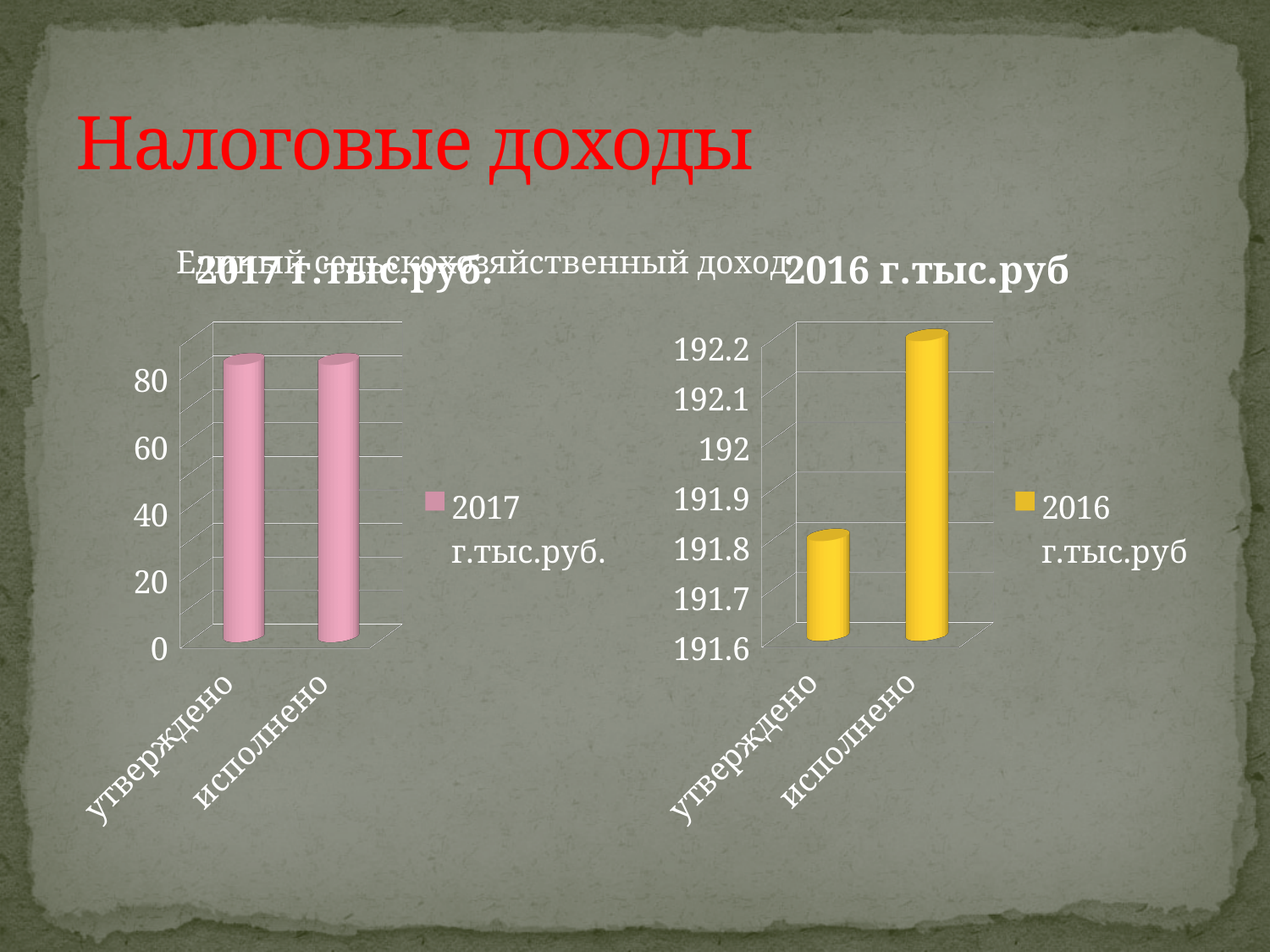
In the right chart (2016 г.тыс.руб), which category has the lowest value? утверждено In the right chart (2016 г.тыс.руб), how many categories are shown on the x axis? 2 In the right chart (2016 г.тыс.руб), which category has the higher value, утверждено or исполнено? исполнено In the left chart (2017 г.тыс.руб.), is the value for утверждено greater or less than 80? greater In the left chart (2017 г.тыс.руб.), how many categories are shown on the x axis? 2 What kind of chart is the left chart titled "2017 г.тыс.руб."? bar chart In the right chart (2016 г.тыс.руб), what colour are the bars? yellow What kind of chart is the right chart titled "2016 г.тыс.руб"? bar chart In the left chart (2017 г.тыс.руб.), is the value for исполнено greater or less than 60? greater In the left chart (2017 г.тыс.руб.), how many series does the legend list? 1 In the right chart (2016 г.тыс.руб), is the value for утверждено greater or less than 192? less